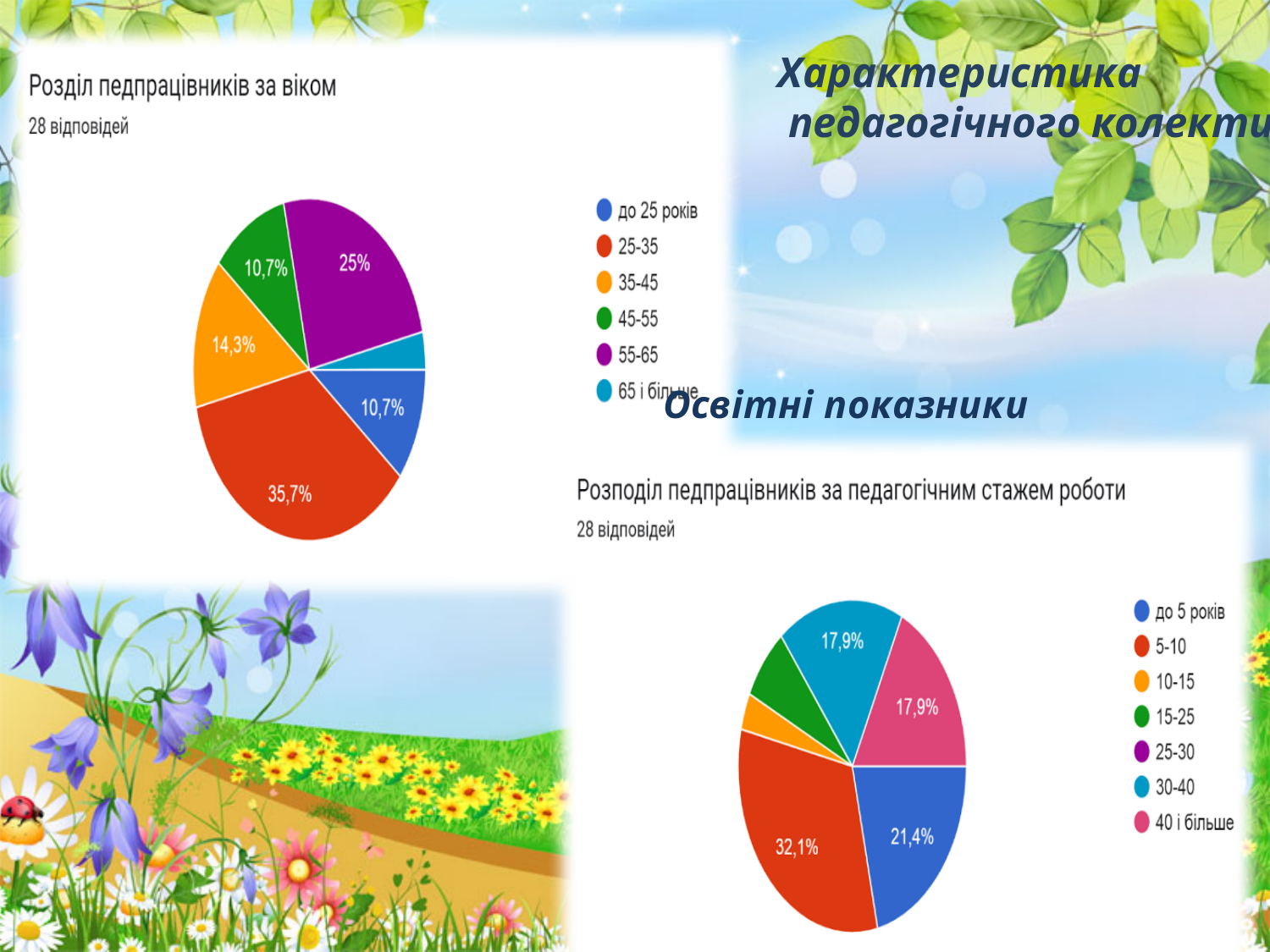
In the chart titled "Розподіл педпрацівників за педагогічним стажем роботи", what share of respondents are in the 5-10 group? 32,1% In the chart titled "Розділ педпрацівників за віком", what share of respondents are in the 35-45 group? 14,3% What type of chart is the chart titled "Розподіл педпрацівників за педагогічним стажем роботи"? Pie chart In the chart titled "Розділ педпрацівників за віком", what share of respondents are in the 55-65 group? 25% In the chart titled "Розділ педпрацівників за віком", how many percentage points larger is the 25-35 share than the 55-65 share? 10,7 In the chart titled "Розподіл педпрацівників за педагогічним стажем роботи", which group has the largest share? 5-10 In the chart titled "Розділ педпрацівників за віком", which age group has the largest share? 25-35 In the chart titled "Розподіл педпрацівників за педагогічним стажем роботи", which is larger: the share for 5-10 or the share for 30-40? 5-10 In the chart titled "Розділ педпрацівників за віком", which age group has the smallest share? 65 і більше In the chart titled "Розділ педпрацівників за віком", what share of respondents are in the 25-35 group? 35,7% In the chart titled "Розподіл педпрацівників за педагогічним стажем роботи", what share of respondents are in the "до 5 років" group? 21,4% In the chart titled "Розділ педпрацівників за віком", how many categories does the legend list? 6